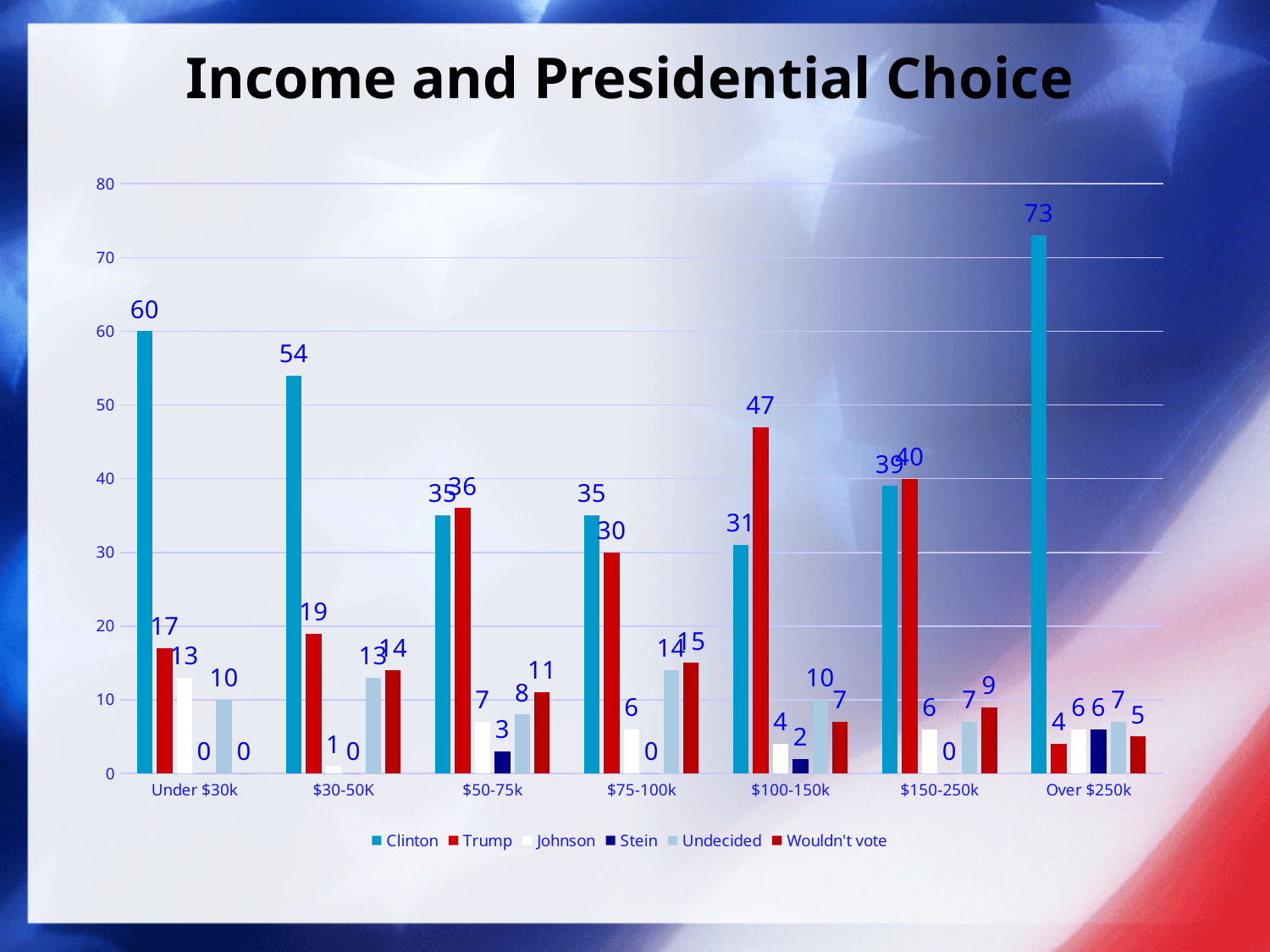
What is the value for Undecided in the $30-50K income group? 13 How many income groups are shown on the x axis? 7 What is the value for Wouldn't vote in the $75-100k income group? 15 What kind of chart is shown on the slide? Bar chart How many series does the legend list? 6 Which is larger in the $100-150k income group, the value for Clinton or the value for Trump? Trump What is the difference between the Clinton and Trump values in the Under $30k income group? 43 Which income group has the highest value for Clinton? Over $250k Which income group has the lowest value for Trump? Over $250k What is the value for Clinton in the Over $250k income group? 73 What is the title of the chart? Income and Presidential Choice What is the value for Trump in the $100-150k income group? 47